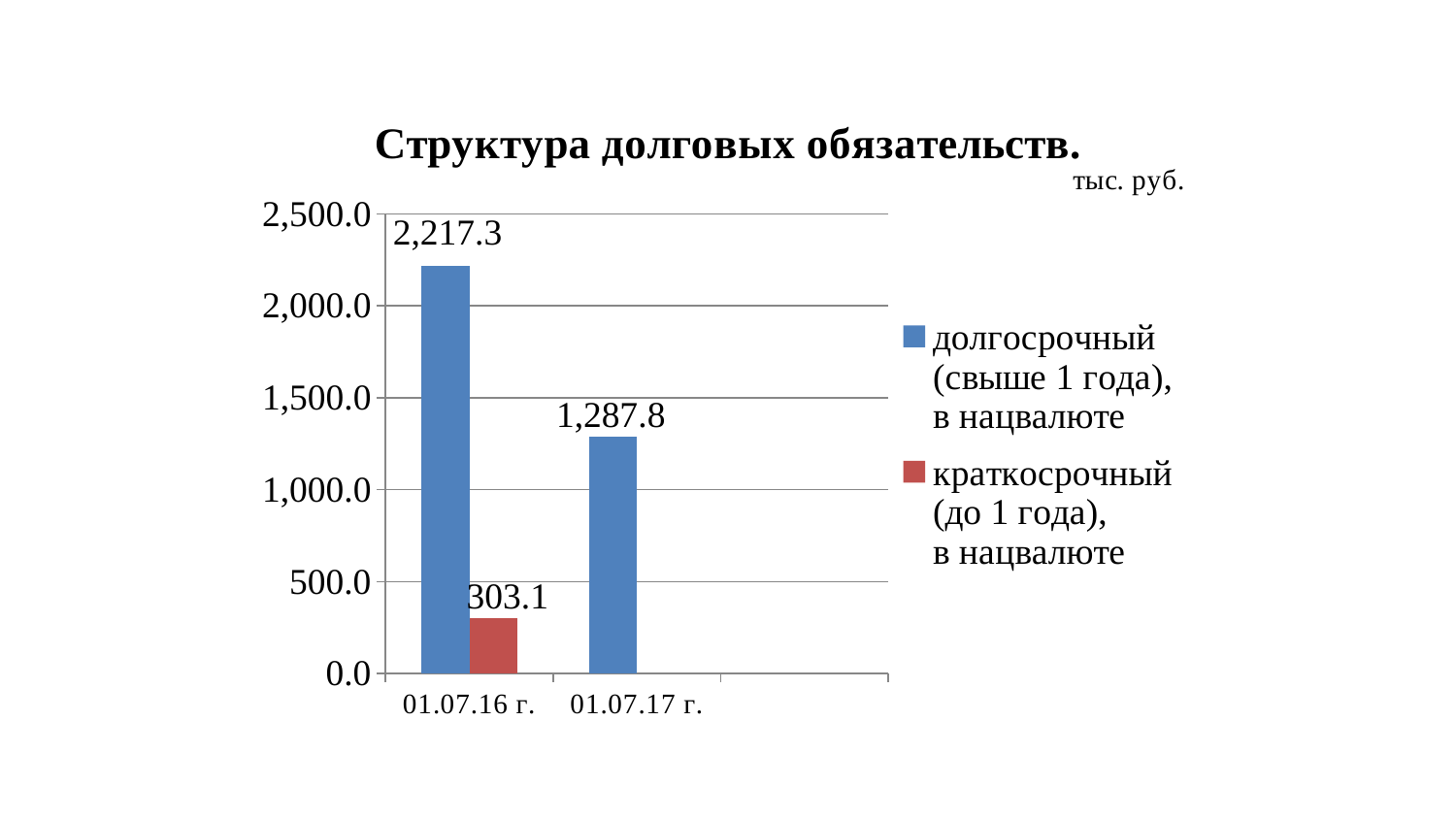
What kind of chart is shown on the slide? bar chart What is the value of the долгосрочный (свыше 1 года), в нацвалюте series for 01.07.16 г.? 2,217.3 What is the value of the краткосрочный (до 1 года), в нацвалюте series for 01.07.16 г.? 303.1 How many series does the legend list? 2 Is the долгосрочный value for 01.07.17 г. greater or less than 1,500.0? less What is the value of the долгосрочный (свыше 1 года), в нацвалюте series for 01.07.17 г.? 1,287.8 By how much did the долгосрочный (свыше 1 года), в нацвалюте value decrease from 01.07.16 г. to 01.07.17 г.? 929.5 Does the долгосрочный (свыше 1 года), в нацвалюте value rise or fall from 01.07.16 г. to 01.07.17 г.? fall Is the долгосрочный value for 01.07.16 г. greater or less than 2,000.0? greater How many dates (categories) are shown on the x axis? 2 Which is larger for 01.07.16 г.: the долгосрочный value or the краткосрочный value? долгосрочный What is the difference between the долгосрочный and краткосрочный values for 01.07.16 г.? 1,914.2